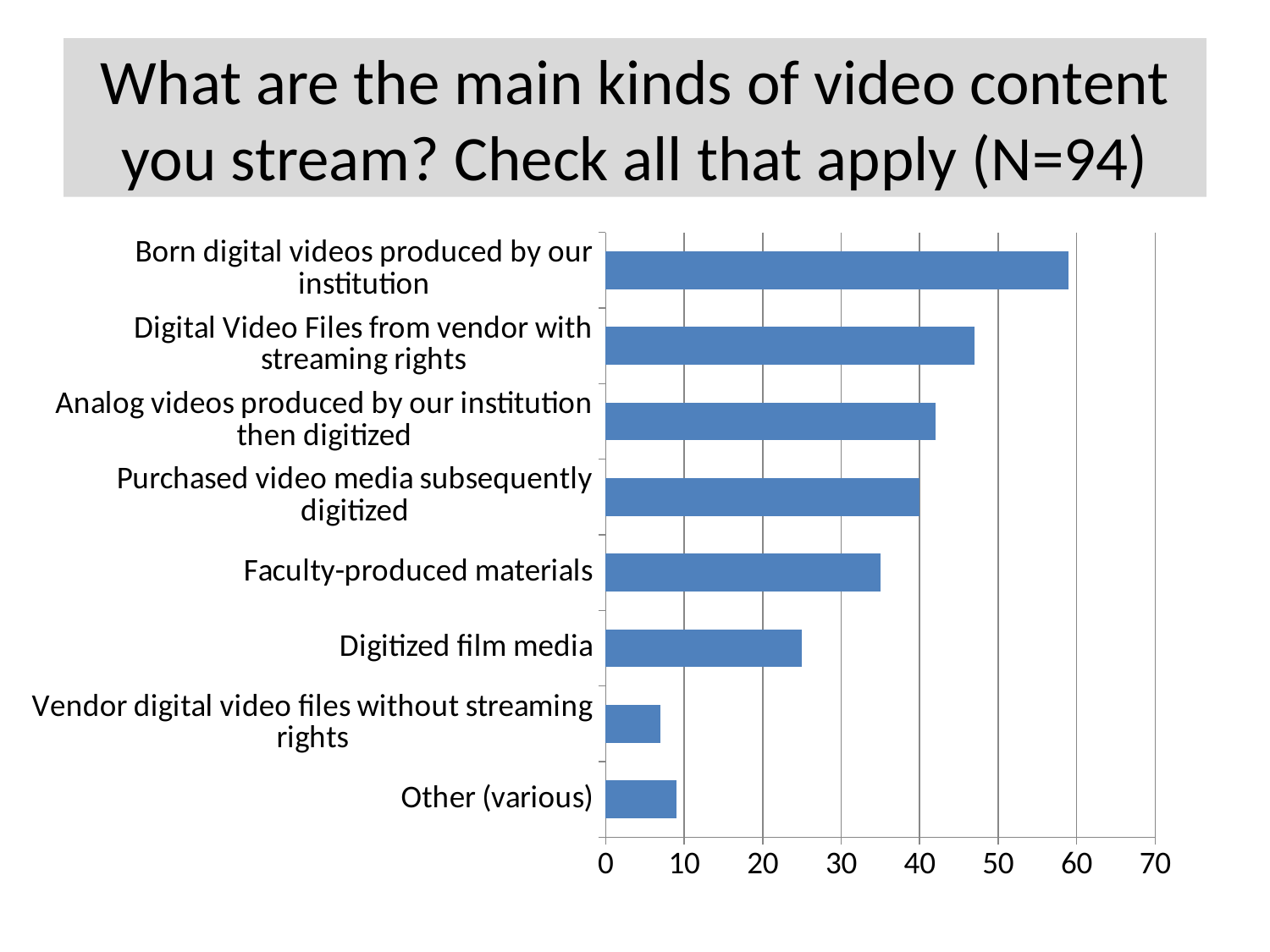
What is the highest value shown on the horizontal axis of the chart? 70 Which category has the highest value in the chart? Born digital videos produced by our institution Is the value for 'Digitized film media' greater or less than 30? less How many categories of video content are shown in the chart? 8 Is the value for 'Other (various)' greater or less than 10? less What kind of chart is shown on the slide? bar chart Is the value for 'Born digital videos produced by our institution' greater or less than 50? greater Which is larger: the value for 'Faculty-produced materials' or 'Digitized film media'? Faculty-produced materials Which is larger: the value for 'Born digital videos produced by our institution' or 'Digital Video Files from vendor with streaming rights'? Born digital videos produced by our institution Which category has the lowest value in the chart? Vendor digital video files without streaming rights